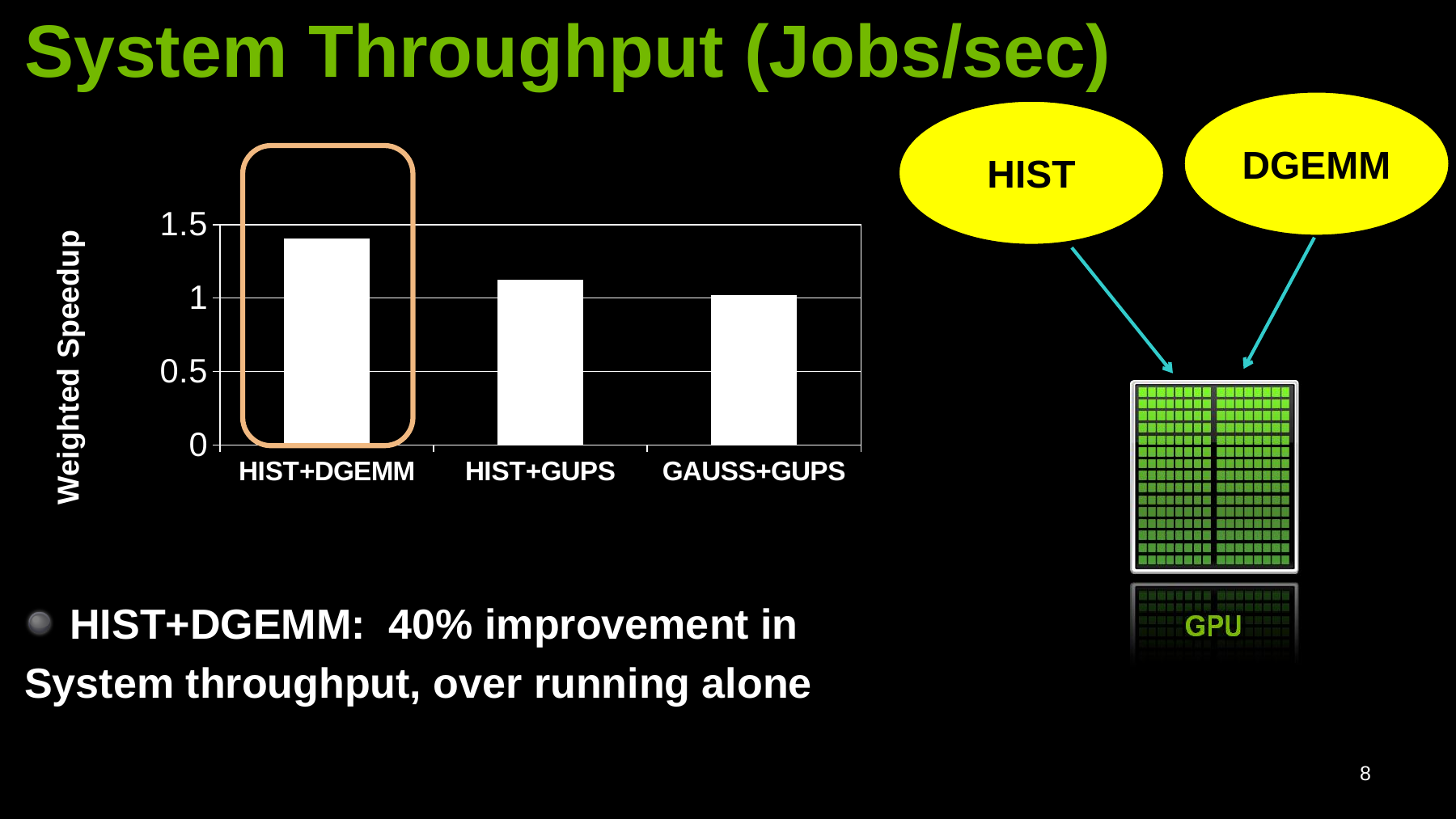
Is the value for HIST+GUPS greater or less than 1? greater Which has a larger weighted speedup, HIST+DGEMM or HIST+GUPS? HIST+DGEMM Which category has the lowest weighted speedup? GAUSS+GUPS Is the value for GAUSS+GUPS greater or less than 0.5? greater Is the value for HIST+DGEMM greater or less than 1? greater What kind of chart is shown on the slide? bar chart What is the label on the y axis of the chart? Weighted Speedup Which category has the highest weighted speedup? HIST+DGEMM How many categories are plotted on the x axis of the chart? 3 Do the bar values rise or fall from left to right along the x axis? fall Which has a larger weighted speedup, HIST+DGEMM or GAUSS+GUPS? HIST+DGEMM